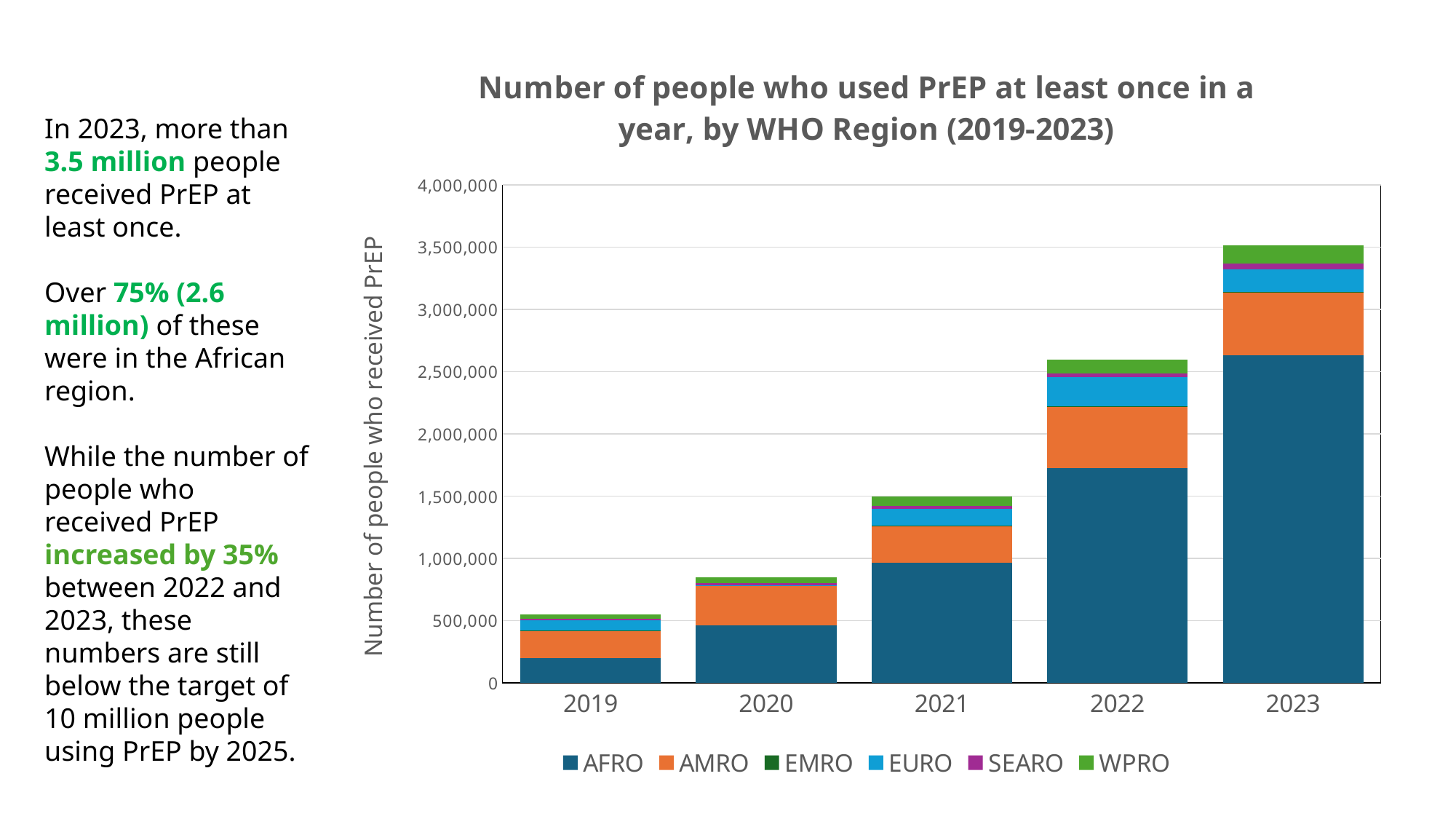
What is the label on the y axis of the chart? Number of people who received PrEP Which year has the highest total number of people who received PrEP? 2023 What is the title of the chart? Number of people who used PrEP at least once in a year, by WHO Region (2019-2023) Is the total number of people who received PrEP in 2019 greater or less than 1,000,000? less Which year has the lowest total number of people who received PrEP? 2019 How many years are shown on the x axis of the chart? 5 Is the total number of people who received PrEP in 2023 greater or less than 3,000,000? greater Do the total numbers of people who received PrEP rise or fall from 2019 to 2023? Rise Is the AFRO value for 2022 greater or less than 1,500,000? greater In 2023, which region has the larger value, AFRO or AMRO? AFRO What kind of chart is shown on the slide? Stacked bar chart How many WHO regions does the legend list? 6